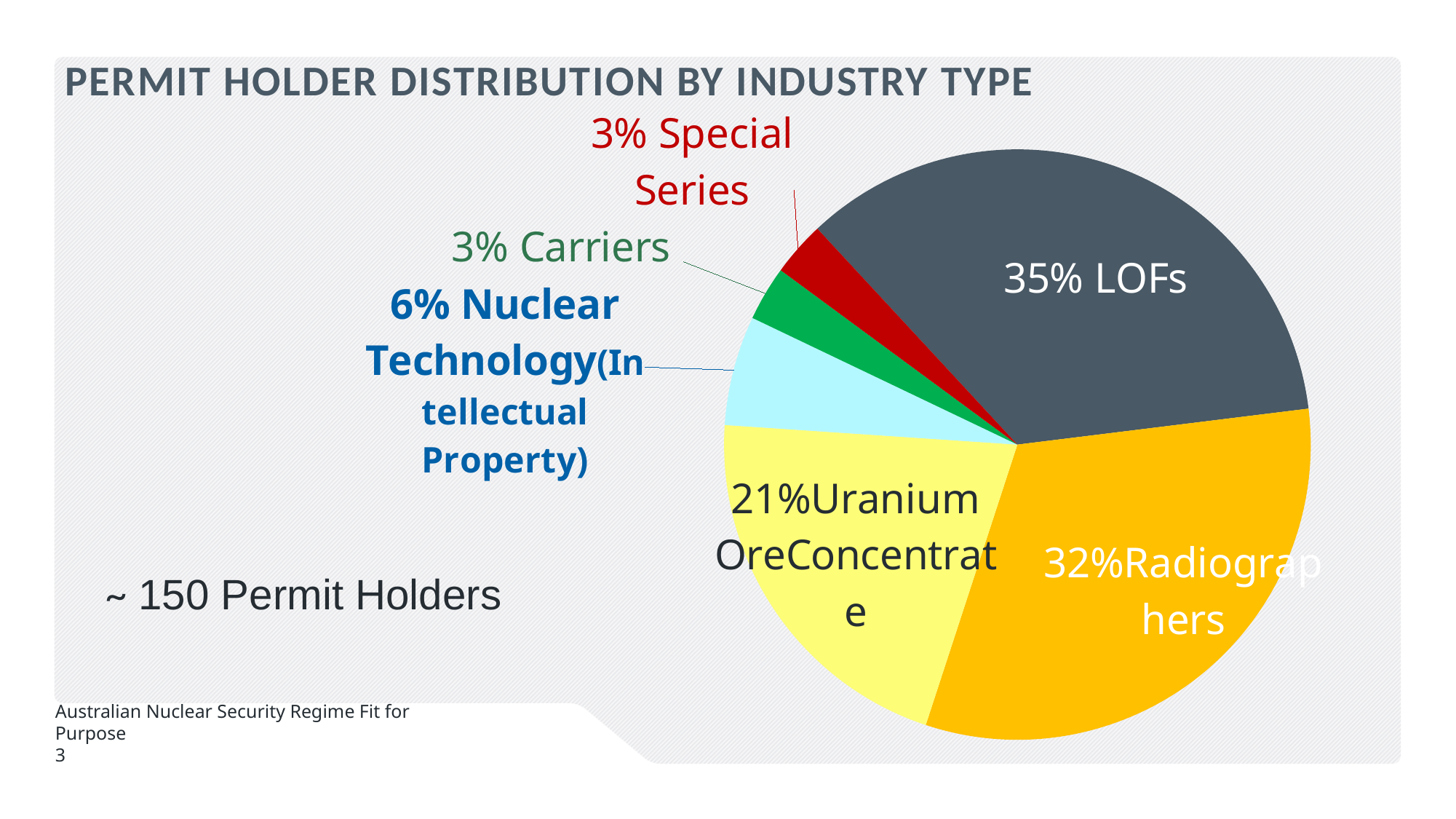
What is the difference in percentage points between LOFs and Radiographers? 3 What colour is the Radiographers slice? Orange/yellow What share of permit holders are LOFs? 35% What share of permit holders are Nuclear Technology (Intellectual Property)? 6% What share of permit holders are Uranium Ore Concentrate? 21% What kind of chart is shown on the slide? Pie chart Which industry type has the largest share of permit holders? LOFs Which is larger, the share for Uranium Ore Concentrate or the share for Nuclear Technology (Intellectual Property)? Uranium Ore Concentrate What is the title of the chart? PERMIT HOLDER DISTRIBUTION BY INDUSTRY TYPE How many slices does the pie chart have? 6